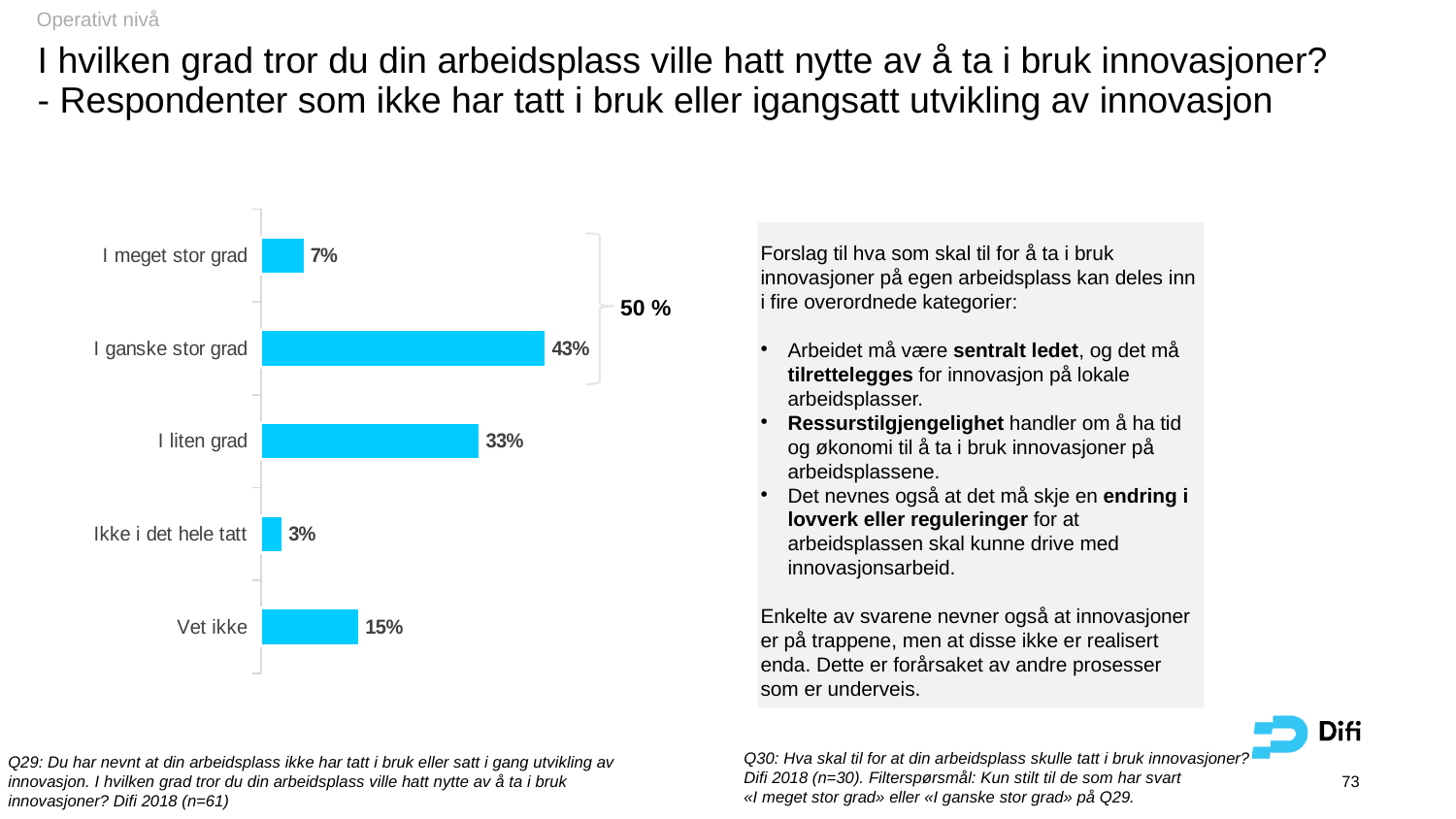
What combined percentage is shown by the bracket next to the top two bars? 50 % Which category has the lowest value? Ikke i det hele tatt What kind of chart is shown on the slide? Bar chart Which category has the highest value? I ganske stor grad What is the value for "I ganske stor grad"? 43% Which is larger, the value for "I liten grad" or the value for "Vet ikke"? I liten grad What is the difference between the values for "I ganske stor grad" and "I liten grad"? 10% What is the value for "Vet ikke"? 15% How many categories are shown in the chart? 5 What is the difference between the values for "Vet ikke" and "Ikke i det hele tatt"? 12% What is the value for "I meget stor grad"? 7% What colour are the bars in the chart? Light blue